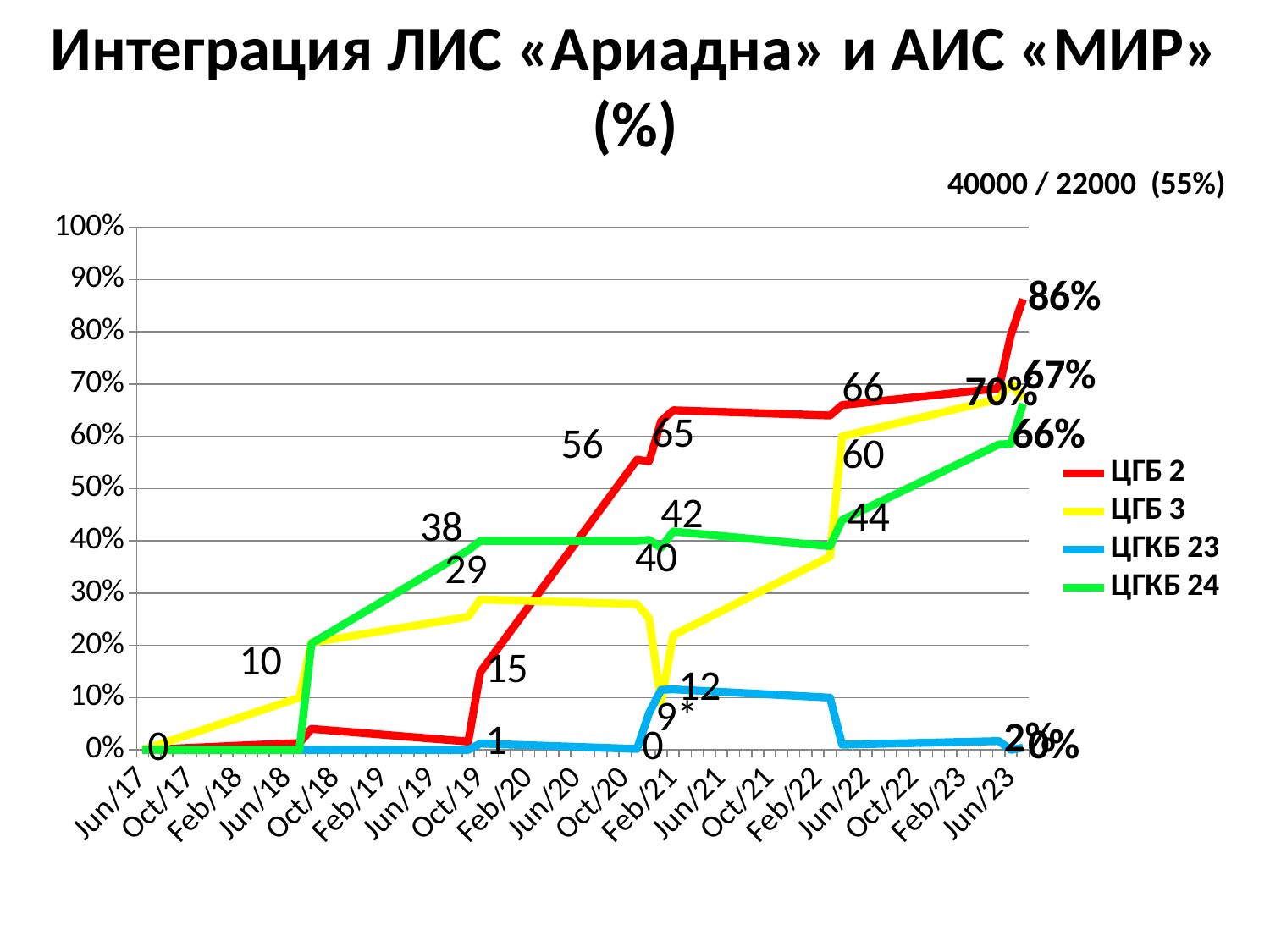
Is the value for ЦГКБ 23 at Jun/22 greater or less than 10%? less How many series does the legend list? 4 What colour is the ЦГБ 2 line in the legend? red What is the final labelled value for ЦГКБ 24 at Jun/23? 66% Which series has the highest value at Jun/23? ЦГБ 2 What is the final labelled value for ЦГБ 2 at Jun/23? 86% What is the final labelled value for ЦГКБ 23 at Jun/23? 0% What is the final labelled value for ЦГБ 3 at Jun/23? 67% Does the ЦГБ 2 line generally rise or fall from Jun/17 to Jun/23? rise Which series has the lowest value at Jun/23? ЦГКБ 23 What type of chart is shown on the slide? line chart